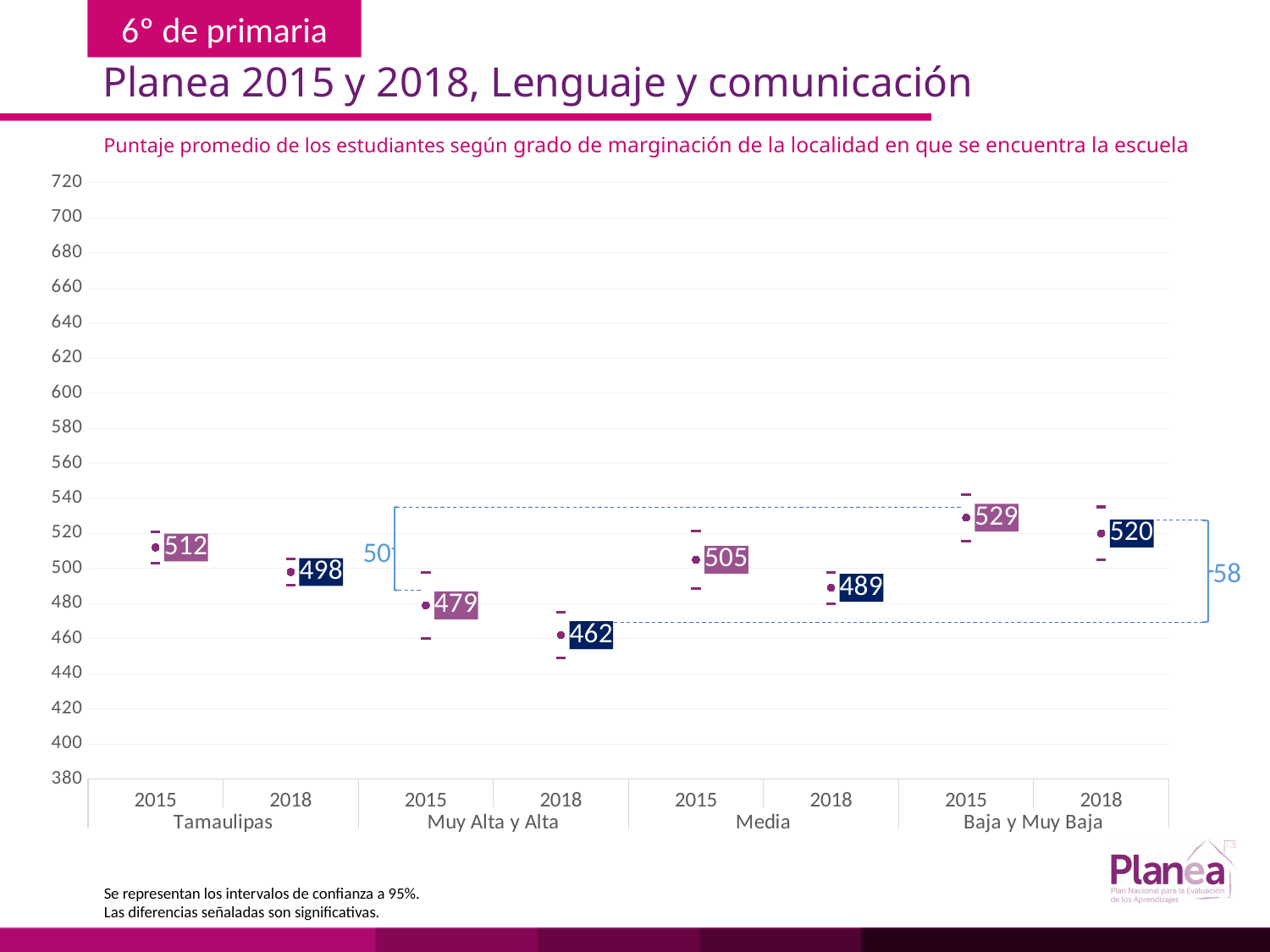
What is the 2018 value for Baja y Muy Baja? 520 Which group and year has the lowest plotted value? Muy Alta y Alta, 2018 What difference is annotated between the 2018 values of Baja y Muy Baja and Muy Alta y Alta? 58 What is the 2018 value for Muy Alta y Alta? 462 What is the difference between the 2015 and 2018 values for Media? 16 Do the values fall from 2015 to 2018 within each group? Yes, they fall Which is larger, the 2018 value for Tamaulipas or the 2018 value for Media? Tamaulipas 2018 What is the difference between the 2015 and 2018 values for Tamaulipas? 14 How many data points are plotted on the chart? 8 What is the 2015 value for Media? 505 What is the 2015 value for Tamaulipas? 512 Which group and year has the highest plotted value? Baja y Muy Baja, 2015